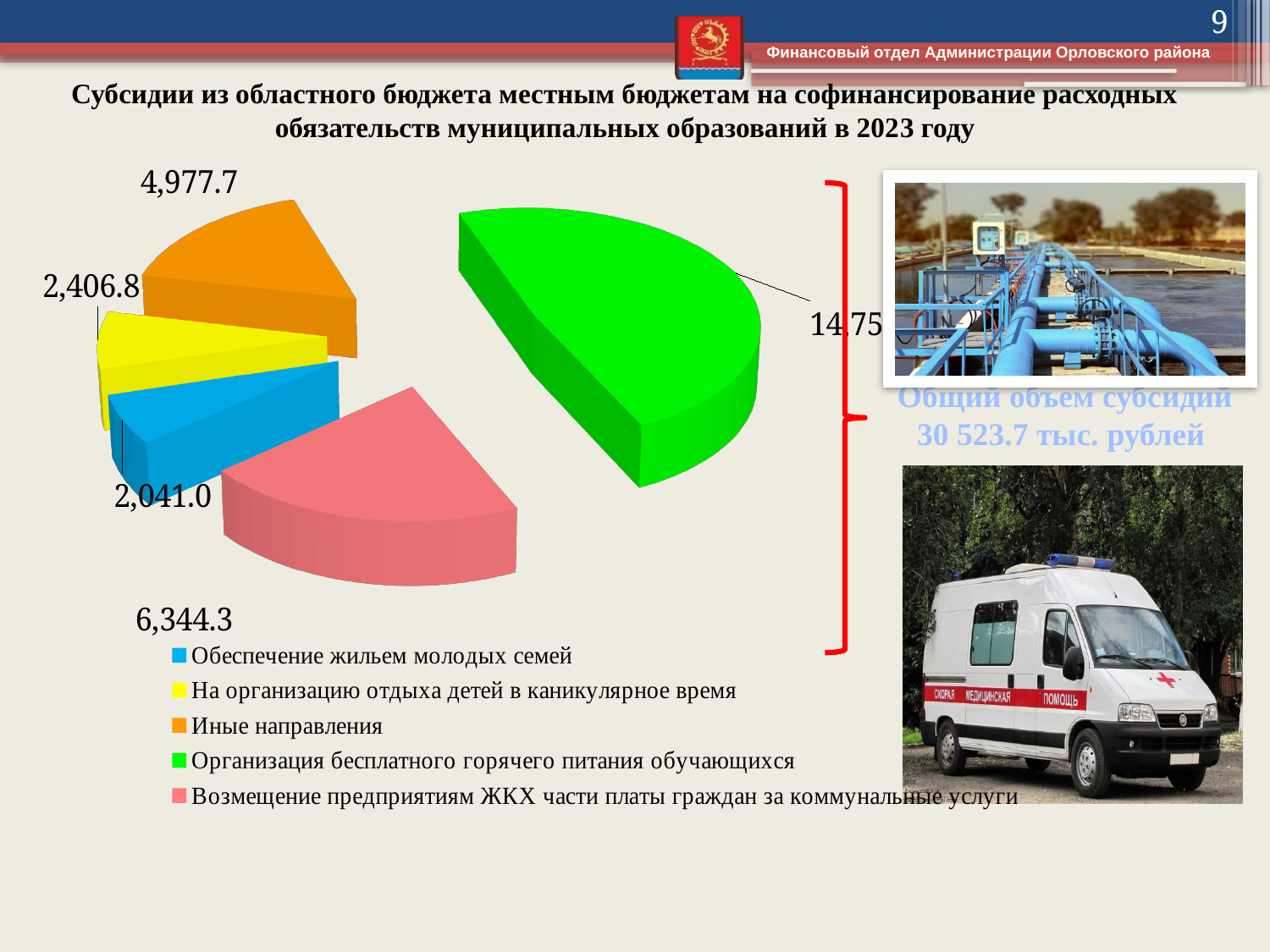
What colour is the slice for Возмещение предприятиям ЖКХ части платы граждан за коммунальные услуги? Pink What is the difference between the values for Возмещение предприятиям ЖКХ части платы граждан за коммунальные услуги and Иные направления? 1,366.6 What is the value for Обеспечение жильем молодых семей? 2,041.0 How many entries does the legend of the pie chart list? 5 What kind of chart is shown on the slide? Pie chart What is the value for На организацию отдыха детей в каникулярное время? 2,406.8 What is the value for Иные направления? 4,977.7 Which is larger: Иные направления or На организацию отдыха детей в каникулярное время? Иные направления What is the value for Возмещение предприятиям ЖКХ части платы граждан за коммунальные услуги? 6,344.3 Which category has the largest slice of the pie? Организация бесплатного горячего питания обучающихся How many slices does the pie chart have? 5 Which category has the smallest slice of the pie? Обеспечение жильем молодых семей